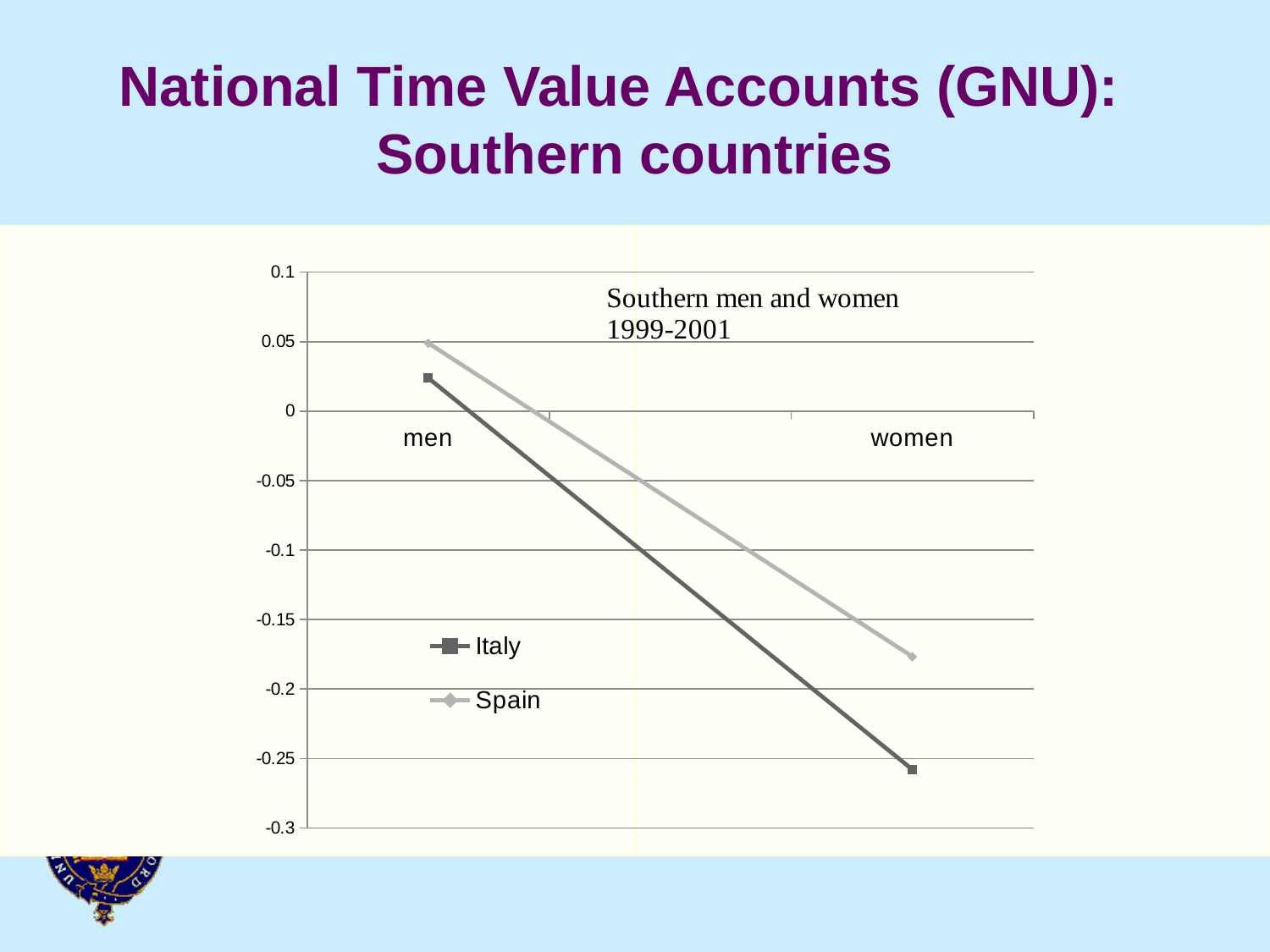
What is the title printed inside the chart area? Southern men and women 1999-2001 Is the value for Italy for women greater or less than -0.2? less For women, which series has the higher value, Italy or Spain? Spain Which series are listed in the chart legend? Italy and Spain Is the value for Spain for women greater or less than -0.2? greater How many series does the chart legend list? 2 Do the values for Italy rise or fall from men to women? fall Do the values for Spain rise or fall from men to women? fall Is the value for Italy for men greater or less than 0? greater How many categories are shown on the x axis? 2 For men, which series has the higher value, Italy or Spain? Spain What kind of chart is shown on the slide? line chart